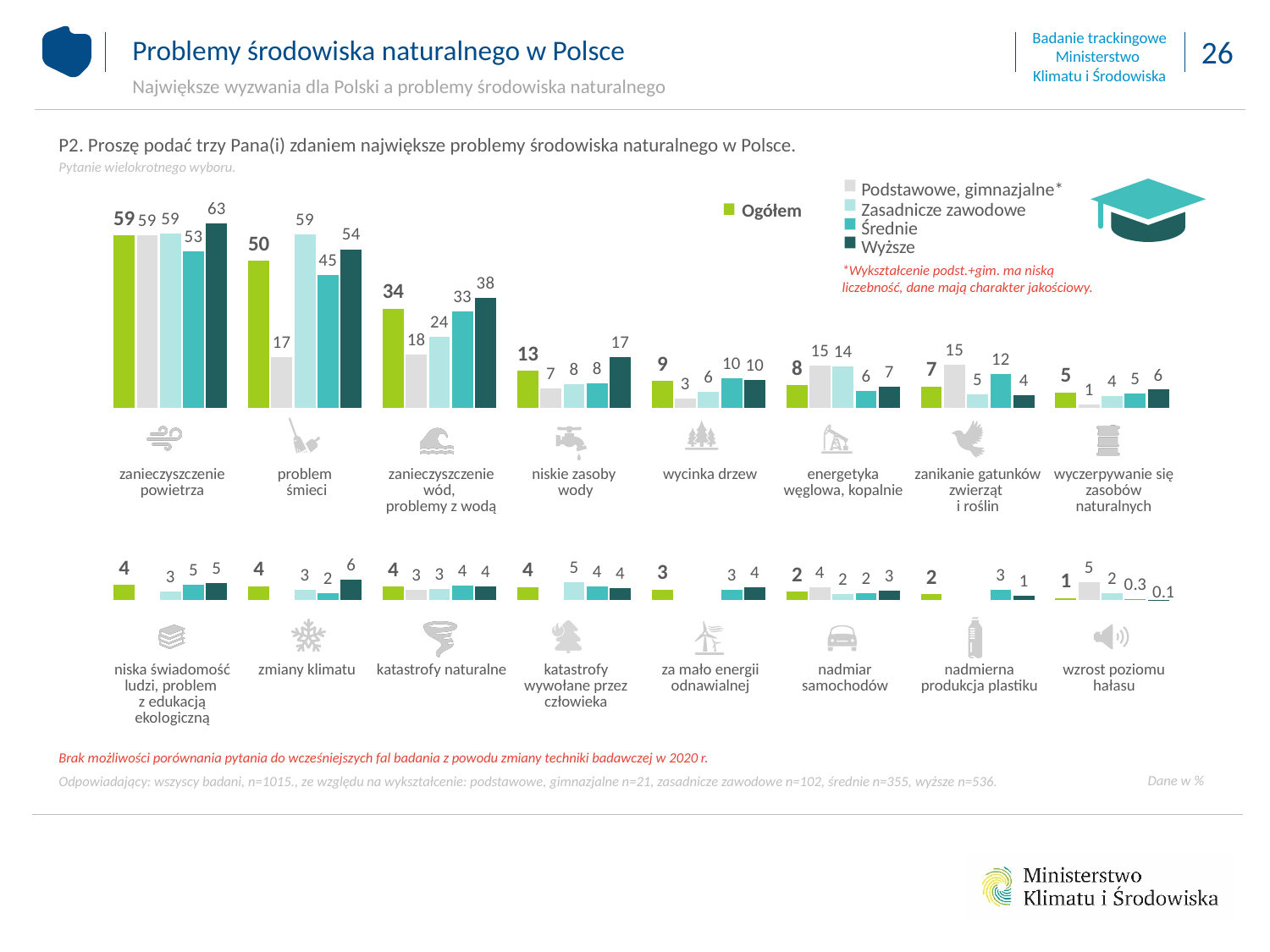
What is the Wyższe value for wzrost poziomu hałasu? 0.1 What kind of chart is shown on the slide? bar chart What is the Ogółem value for zanieczyszczenie powietrza? 59 What is the Wyższe value for zanieczyszczenie powietrza? 63 Which category has the highest Ogółem value? zanieczyszczenie powietrza What is the Podstawowe, gimnazjalne value for problem śmieci? 17 Which category has the lowest Ogółem value? wzrost poziomu hałasu What is the difference between the Wyższe and Podstawowe, gimnazjalne values for niskie zasoby wody? 10 How many series does the legend list? 5 For zanikanie gatunków zwierząt i roślin, which is larger: the Podstawowe, gimnazjalne value or the Wyższe value? Podstawowe, gimnazjalne What is the Ogółem value for problem śmieci? 50 What is the Ogółem value for wycinka drzew? 9